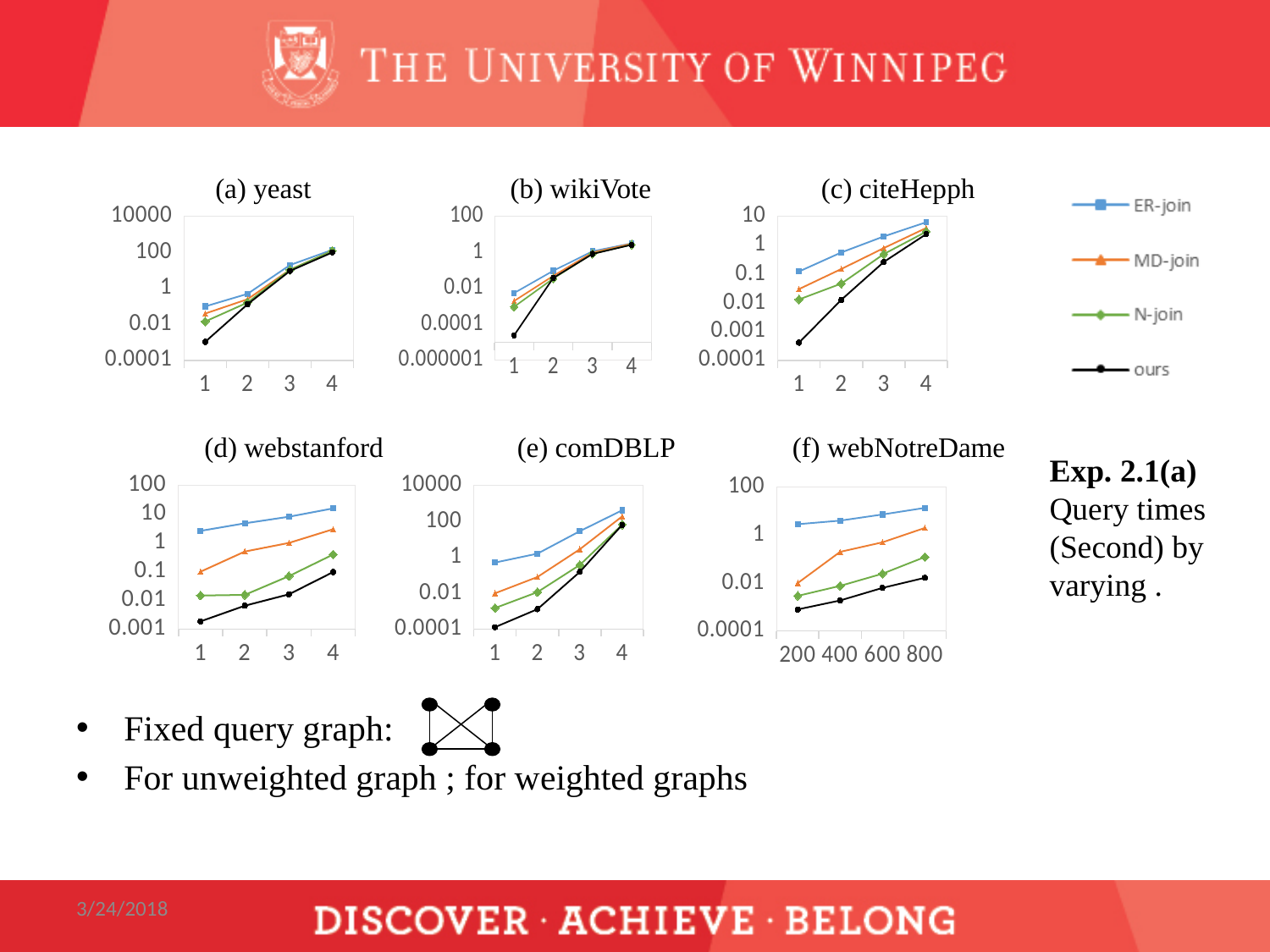
In the (f) webNotreDame chart, does the ER-join series rise or fall as the x value increases from 200 to 800? rise In the (d) webstanford chart, which series has the highest value at x = 1? ER-join In the (a) yeast chart, is the value for ours at x = 1 greater or less than 0.01? less In the (d) webstanford chart, is the value for ER-join at x = 4 greater or less than 10? greater In the (b) wikiVote chart, is the value for ours at x = 1 greater or less than 0.0001? less What kind of chart is the (a) yeast chart? line chart In the (c) citeHepph chart, which series has the lowest value at x = 1? ours How many series does the legend list? 4 In the (f) webNotreDame chart, which is larger at x = 200: ER-join or ours? ER-join How many x-axis points are plotted in the (f) webNotreDame chart? 4